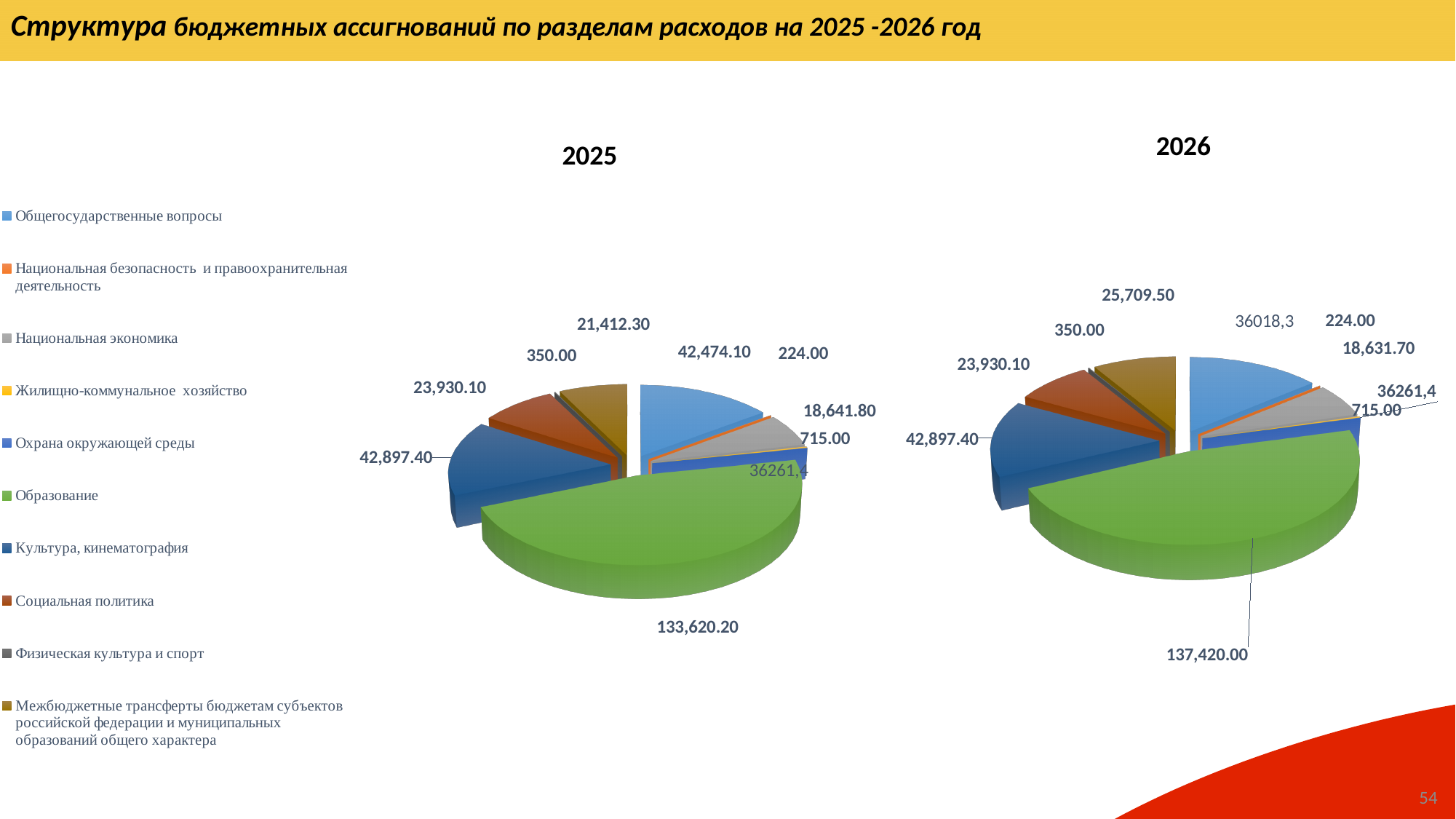
What is the title of the slide? Структура бюджетных ассигнований по разделам расходов на 2025 -2026 год In the 2025 chart, which category has the largest share? Образование In the 2026 chart, what is the value for Образование? 137,420.00 Which is larger: the value for Образование in the 2026 chart or in the 2025 chart? 2026 In the 2025 chart, what is the value for Культура, кинематография? 42,897.40 What kind of charts are shown on the slide? Pie charts In the 2026 chart, what is the value for Социальная политика? 23,930.10 In the 2025 chart, what is the value for Образование? 133,620.20 How many categories does the legend list? 10 In the 2026 chart, which category has the largest share? Образование In the 2025 chart, what is the value for Общегосударственные вопросы? 42,474.10 In the 2025 chart, what is the difference between the values for Образование and Культура, кинематография? 90,722.80